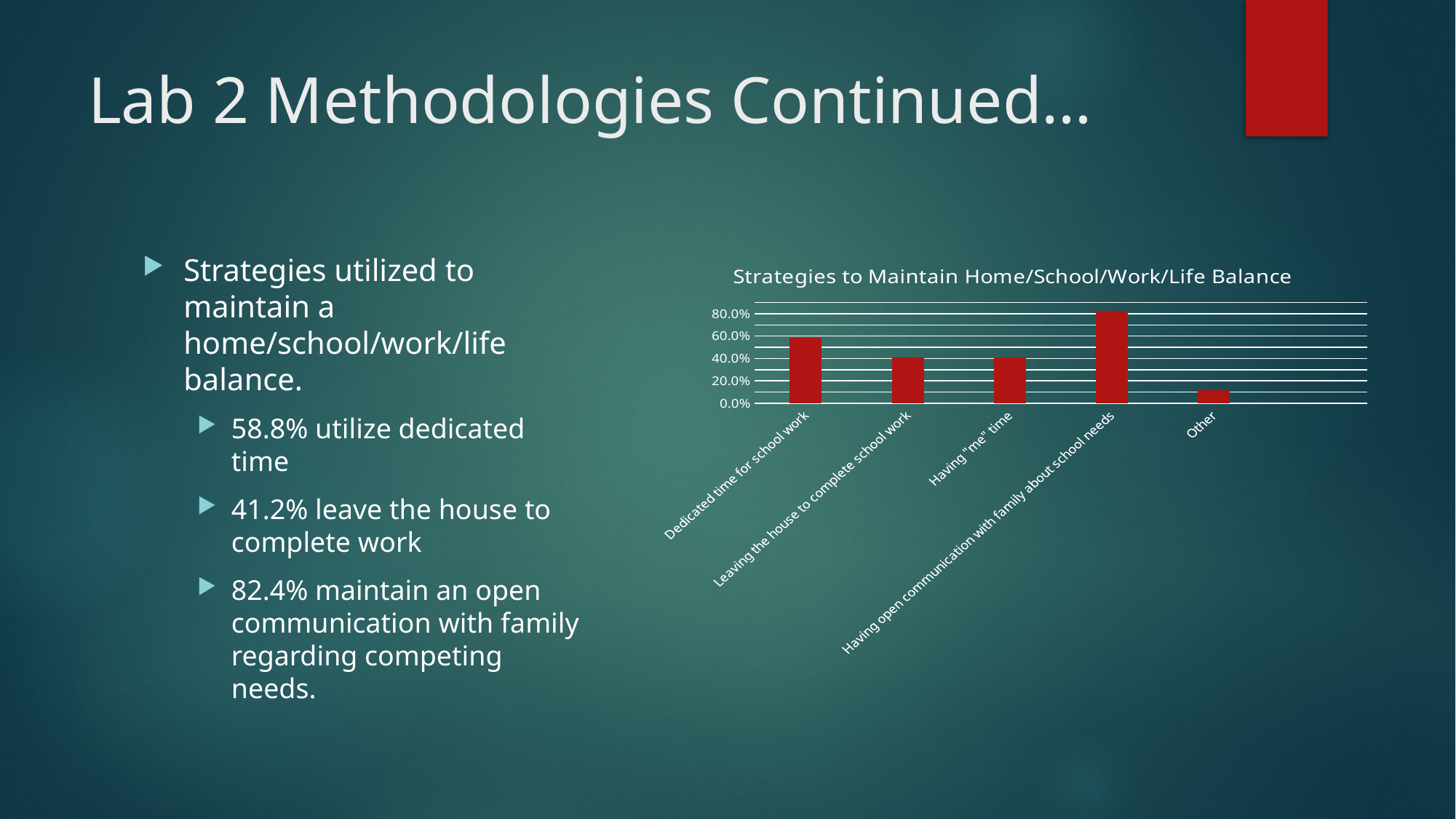
How many categories are shown on the x axis of the chart? 5 What is the title of the chart? Strategies to Maintain Home/School/Work/Life Balance Which category has the lowest bar in the chart? Other Is the value for "Having open communication with family about school needs" greater or less than 60.0%? greater Which category has the highest bar in the chart? Having open communication with family about school needs Is the value for "Dedicated time for school work" greater or less than 40.0%? greater Is the value for "Having "me" time" greater or less than 20.0%? greater Which is larger: the bar for "Dedicated time for school work" or the bar for "Leaving the house to complete school work"? Dedicated time for school work What kind of chart is shown on the slide? bar chart What colour are the bars in the chart? red